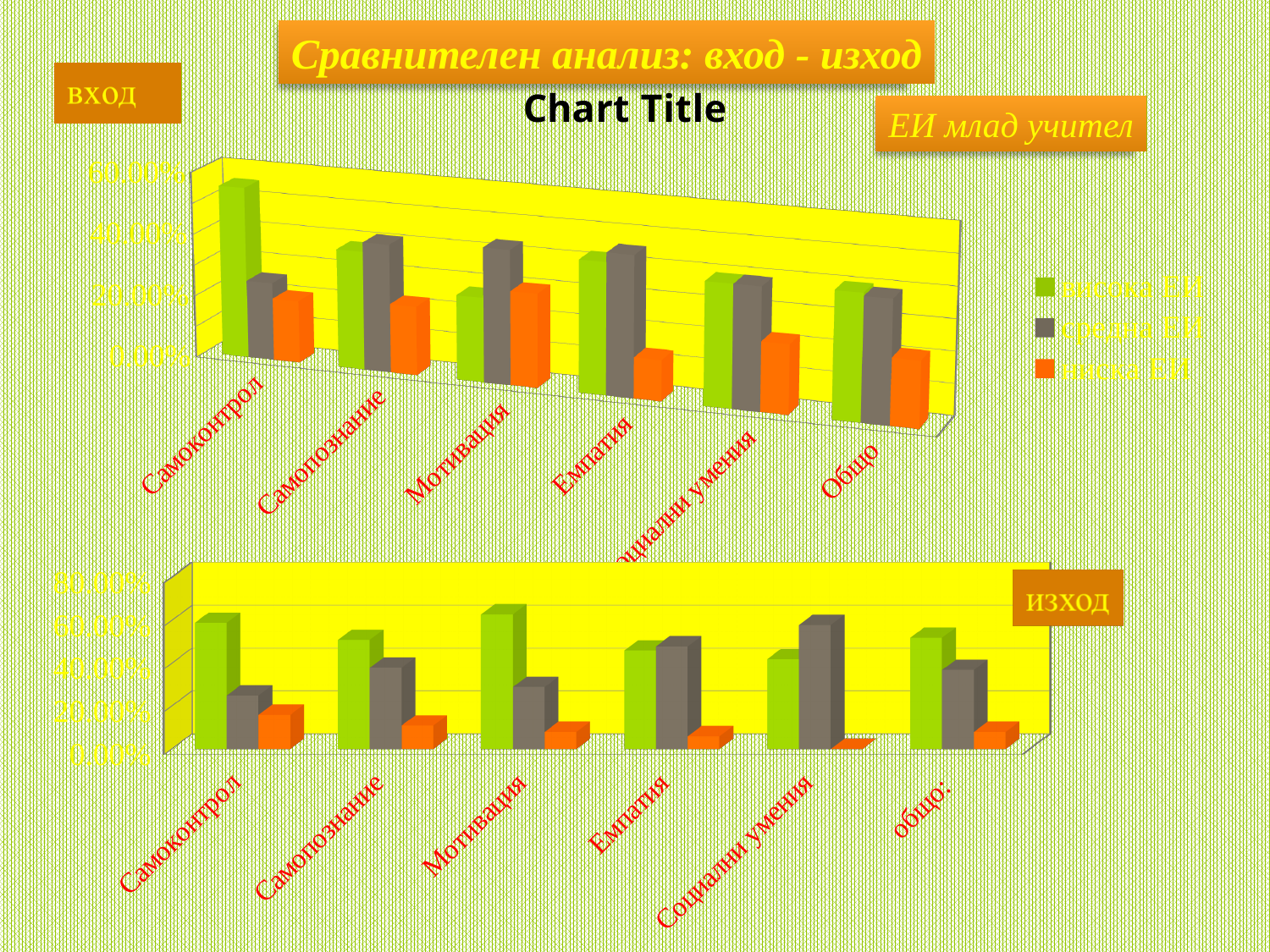
In the top chart titled "Chart Title", which category has the tallest bar overall? Самоконтрол In the top chart titled "Chart Title", which is larger for Самоконтрол: висока ЕИ or средна ЕИ? висока ЕИ In the bottom chart (изход), is the value for висока ЕИ in Мотивация greater or less than 40.00%? greater What is the highest value shown on the vertical axis of the bottom chart (изход)? 80.00% In the bottom chart (изход), is the value for ниска ЕИ in Социални умения greater or less than 20.00%? less How many categories are shown on the x axis of the bottom chart (изход)? 6 In the top chart titled "Chart Title", is the value for ниска ЕИ in Емпатия greater or less than 20.00%? less What kind of chart is the top chart titled "Chart Title"? bar chart In the bottom chart (изход), which is larger for Социални умения: висока ЕИ or средна ЕИ? средна ЕИ How many series does the legend of the top chart titled "Chart Title" list? 3 How many categories are shown on the x axis of the top chart titled "Chart Title"? 6